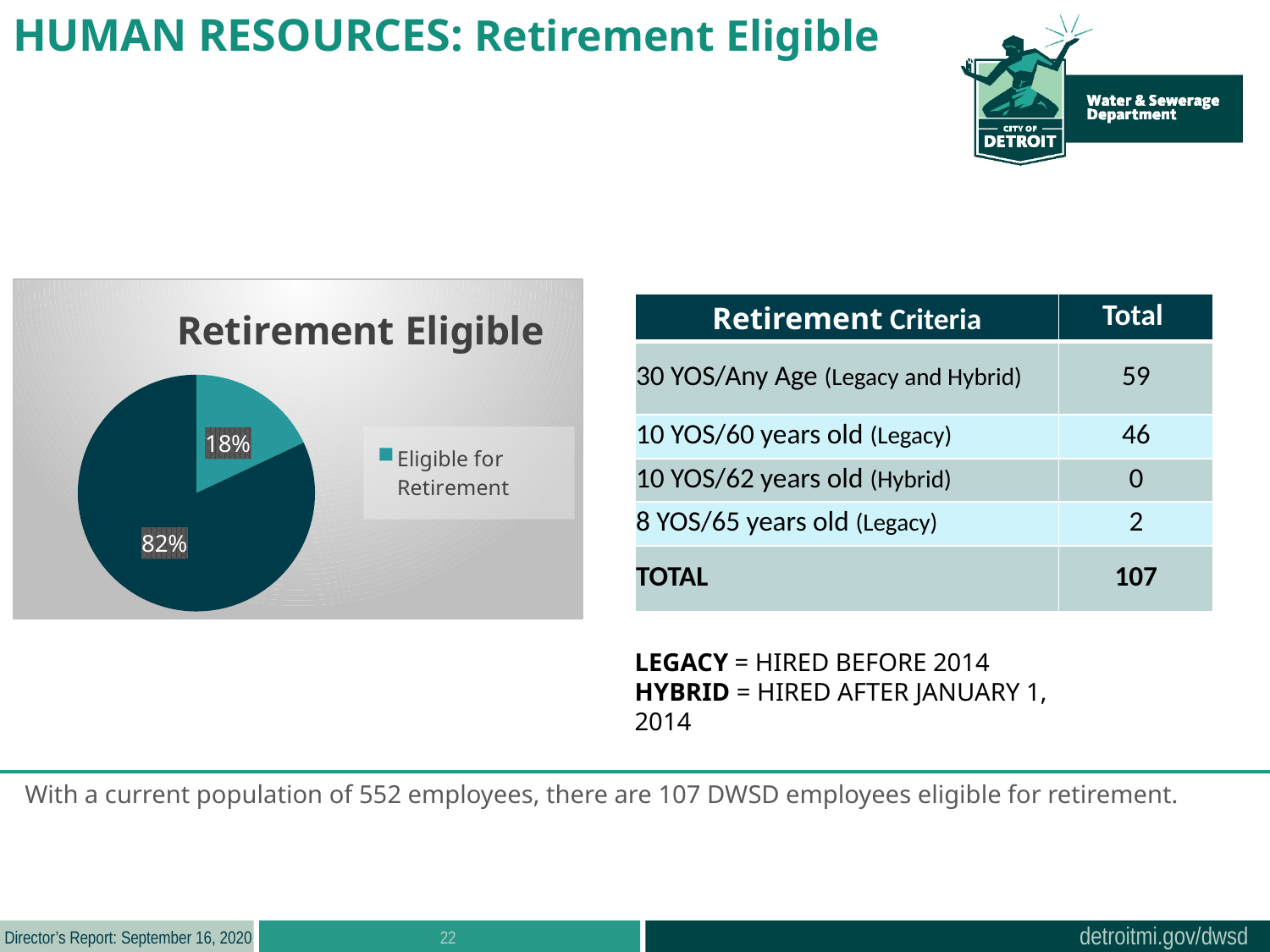
What is the title of the pie chart? Retirement Eligible What percentage does the 'Eligible for Retirement' slice of the pie chart show? 18% What is the value of the largest slice in the pie chart? 82% How many slices does the pie chart have? 2 What kind of chart is shown on the slide? Pie chart How many entries does the pie chart's legend list? 1 What is the difference in percentage points between the two slices of the pie chart? 64 What percentage is shown on the larger, dark slice of the pie chart? 82% Is the 'Eligible for Retirement' slice of the pie chart greater or less than 50%? less Which slice of the pie chart is larger, the teal 'Eligible for Retirement' slice or the dark slice? The dark slice What colour is the 'Eligible for Retirement' slice in the pie chart? Teal What is the value of the smallest slice in the pie chart? 18%